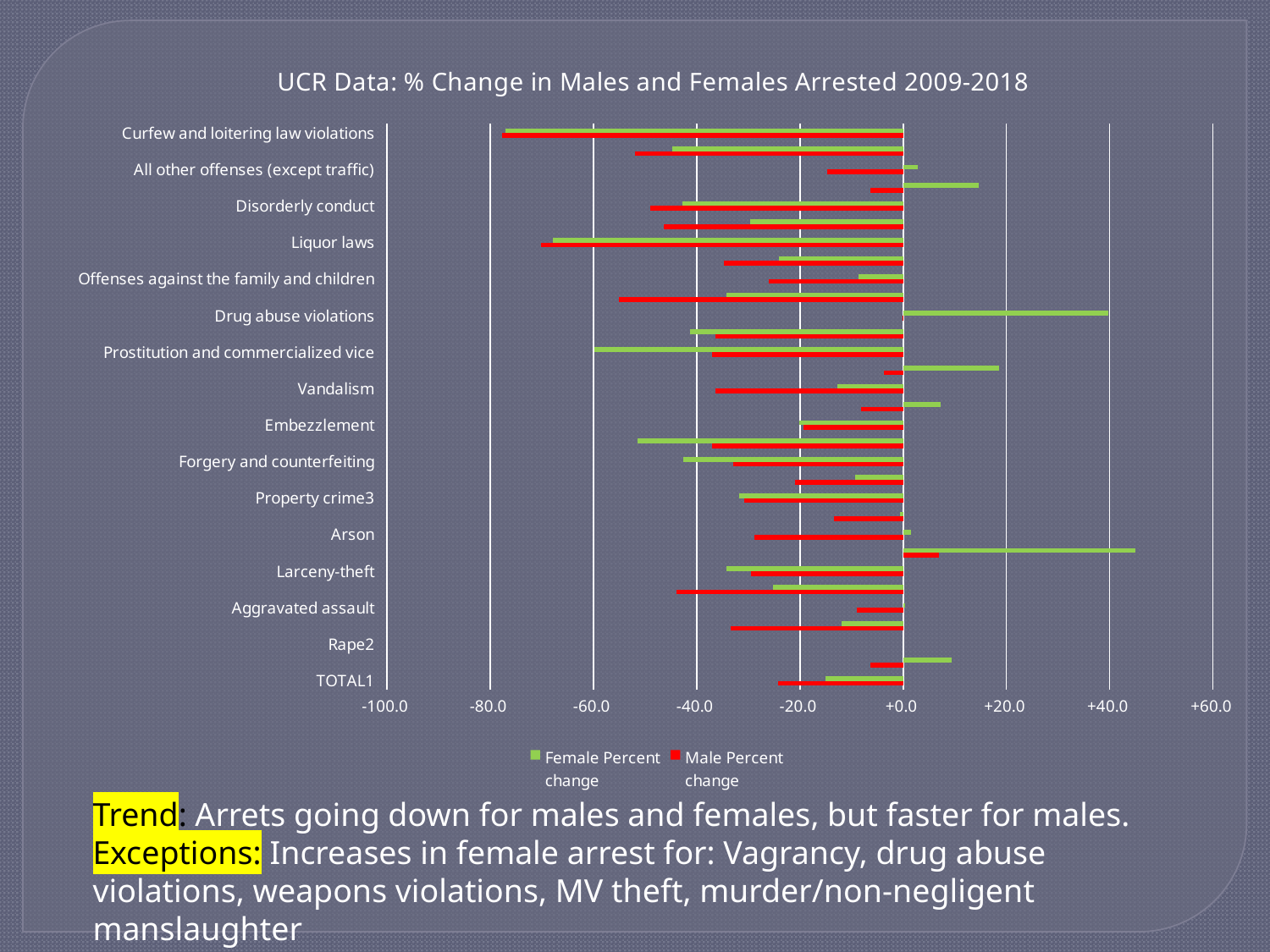
Is the Female Percent change for Liquor laws greater or less than -60.0? less Is the Female Percent change for Curfew and loitering law violations greater or less than -60.0? less Is the Female Percent change for Drug abuse violations greater or less than +20.0? greater What kind of chart is shown on the slide? Bar chart Which has the larger Female Percent change: Drug abuse violations or Curfew and loitering law violations? Drug abuse violations How many series does the chart's legend list? 2 For Drug abuse violations, which is larger: the Female Percent change or the Male Percent change? Female Percent change What are the two series named in the chart's legend? Female Percent change and Male Percent change What is the title of the chart? UCR Data: % Change in Males and Females Arrested 2009-2018